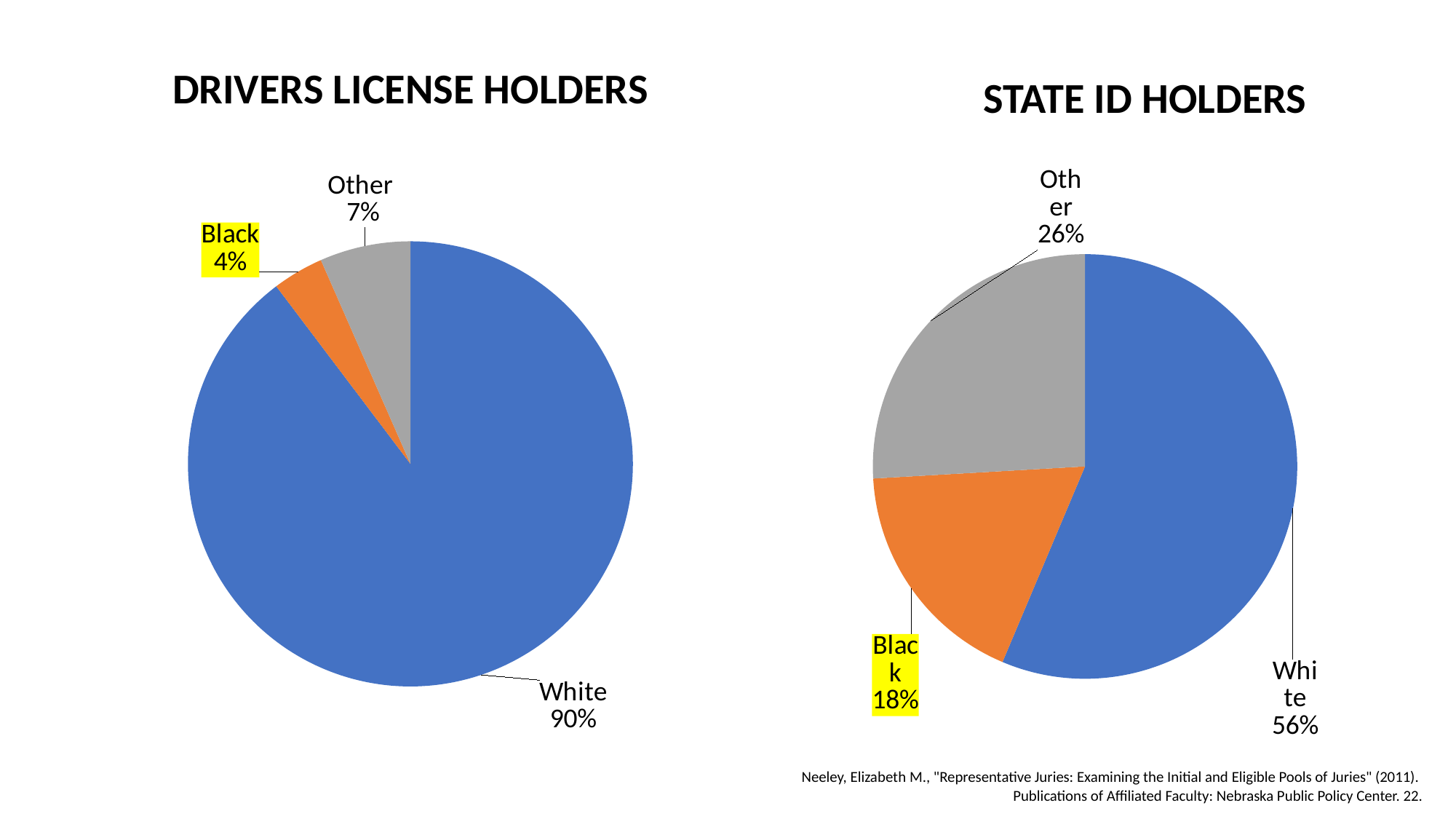
What kind of chart is the STATE ID HOLDERS chart? Pie chart In the DRIVERS LICENSE HOLDERS chart, which category has the smallest slice? Black In the STATE ID HOLDERS chart, what share is Other? 26% In the STATE ID HOLDERS chart, what share is Black? 18% In the DRIVERS LICENSE HOLDERS chart, what share is White? 90% In the STATE ID HOLDERS chart, which category has the largest slice? White How many categories does the DRIVERS LICENSE HOLDERS chart show? 3 In the STATE ID HOLDERS chart, what share is White? 56% In the DRIVERS LICENSE HOLDERS chart, what share is Other? 7% What is the difference between the Black share in the STATE ID HOLDERS chart and the Black share in the DRIVERS LICENSE HOLDERS chart? 14% In the DRIVERS LICENSE HOLDERS chart, what share is Black? 4% Which is larger: the Other share in the STATE ID HOLDERS chart or the Other share in the DRIVERS LICENSE HOLDERS chart? STATE ID HOLDERS